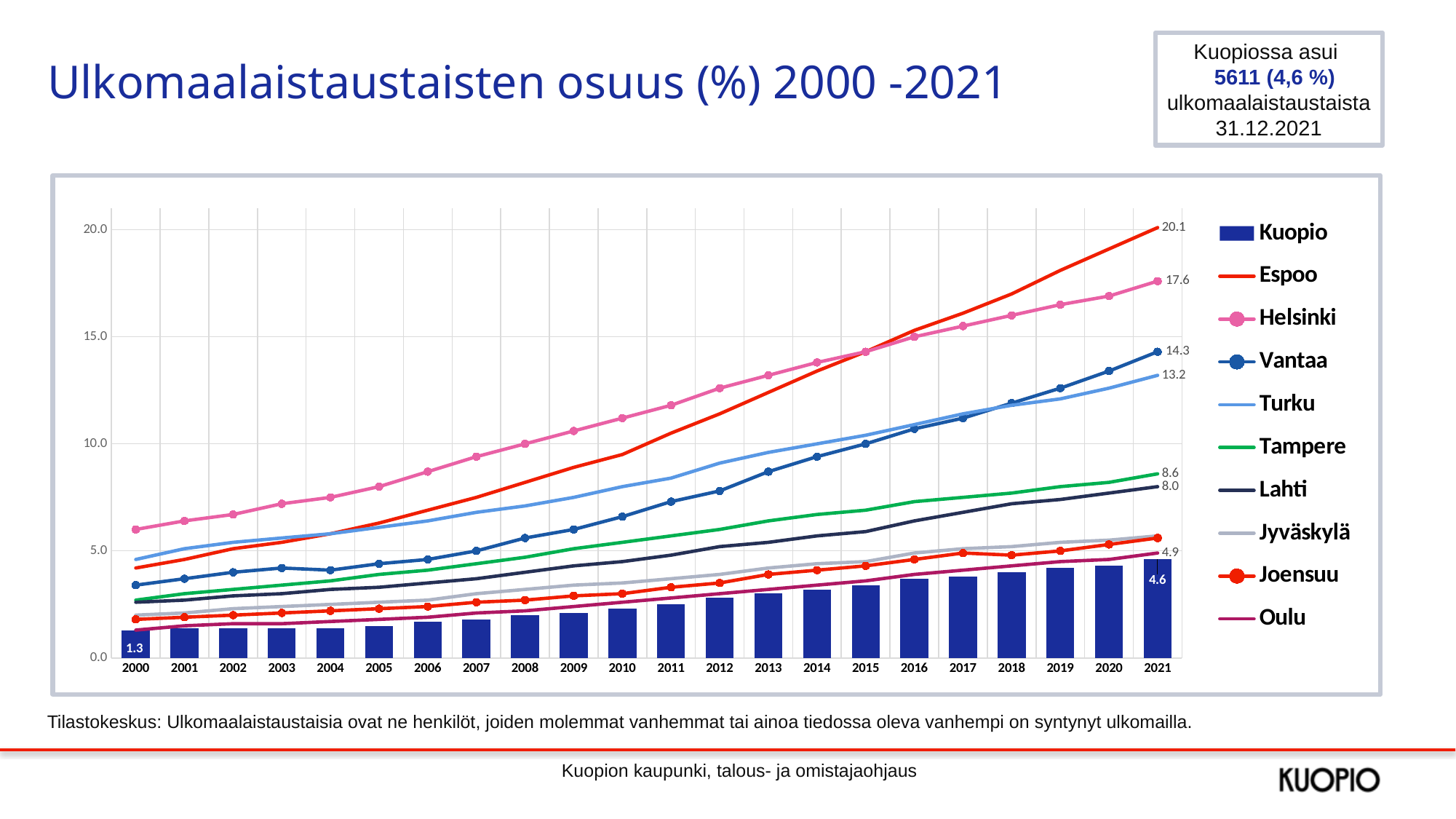
Is the value for Helsinki in 2000 greater or less than 5.0? greater What is the value for Turku in 2021? 13.2 How many series does the legend list? 10 What is the value for Vantaa in 2021? 14.3 What is the value for Kuopio in 2000? 1.3 Which city has the highest value in 2021? Espoo By how much did the Kuopio value increase from 2000 to 2021? 3.3 What is the value for Helsinki in 2021? 17.6 What is the difference between the 2021 values for Espoo and Helsinki? 2.5 What is the value for Espoo in 2021? 20.1 What is the value for Kuopio in 2021? 4.6 Which is larger in 2021, the value for Tampere or the value for Lahti? Tampere